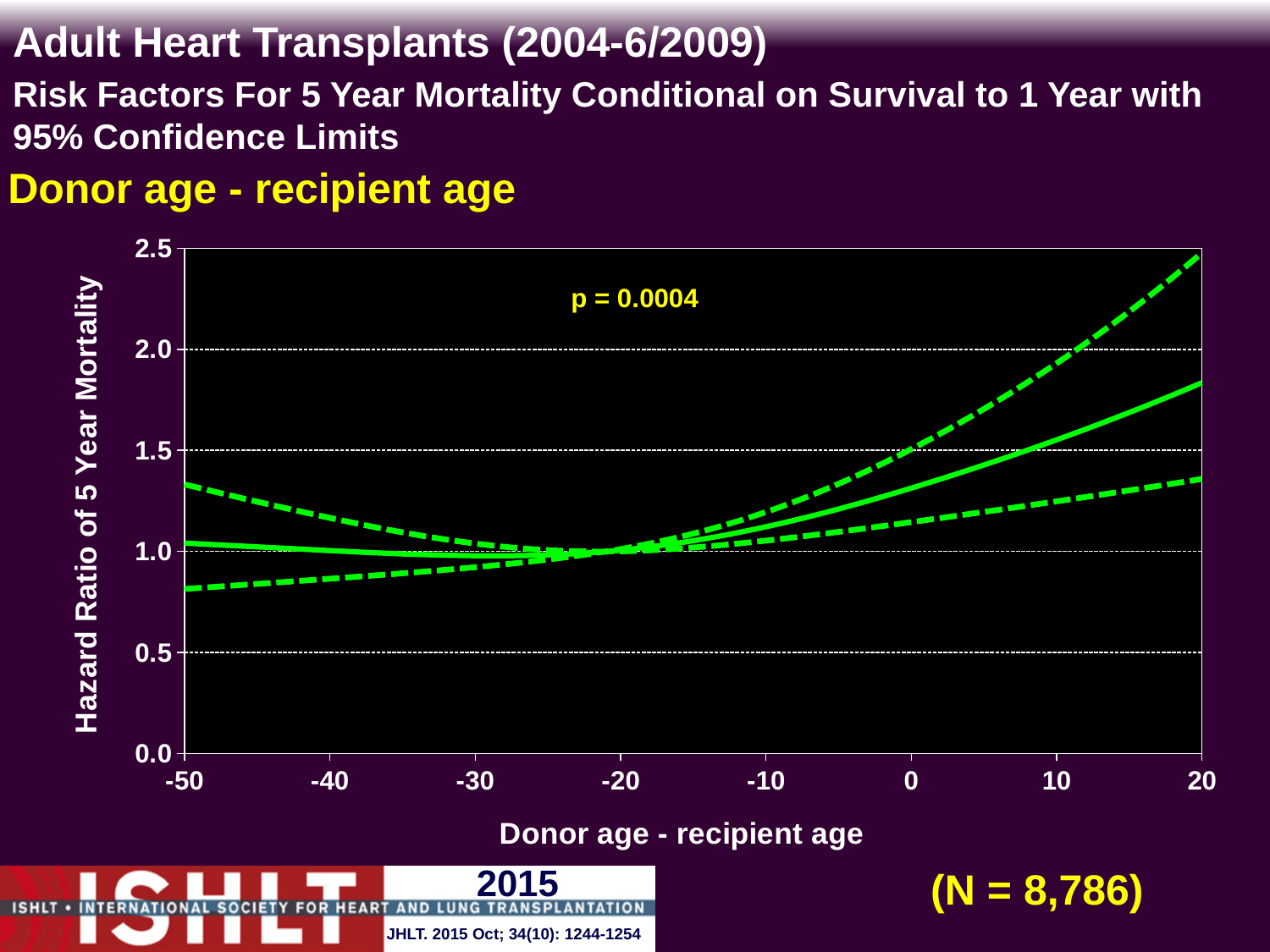
Is the upper dashed confidence limit at a donor-recipient age difference of 20 greater or less than 2.0? greater How many tick labels are shown on the x axis? 8 Is the hazard ratio of the solid line at a donor-recipient age difference of 20 greater or less than 1.5? greater Does the upper dashed confidence limit rise or fall as the donor-recipient age difference increases from -50 to -20? fall Is the upper dashed confidence limit at a donor-recipient age difference of -50 greater or less than 1.0? greater Does the solid hazard ratio line rise or fall as the donor-recipient age difference increases from -20 to 20? rise What kind of chart is shown on the slide? line chart What is the p-value printed on the chart? p = 0.0004 What is the sample size (N) shown on the slide? N = 8,786 How many lines are plotted on the chart? 3